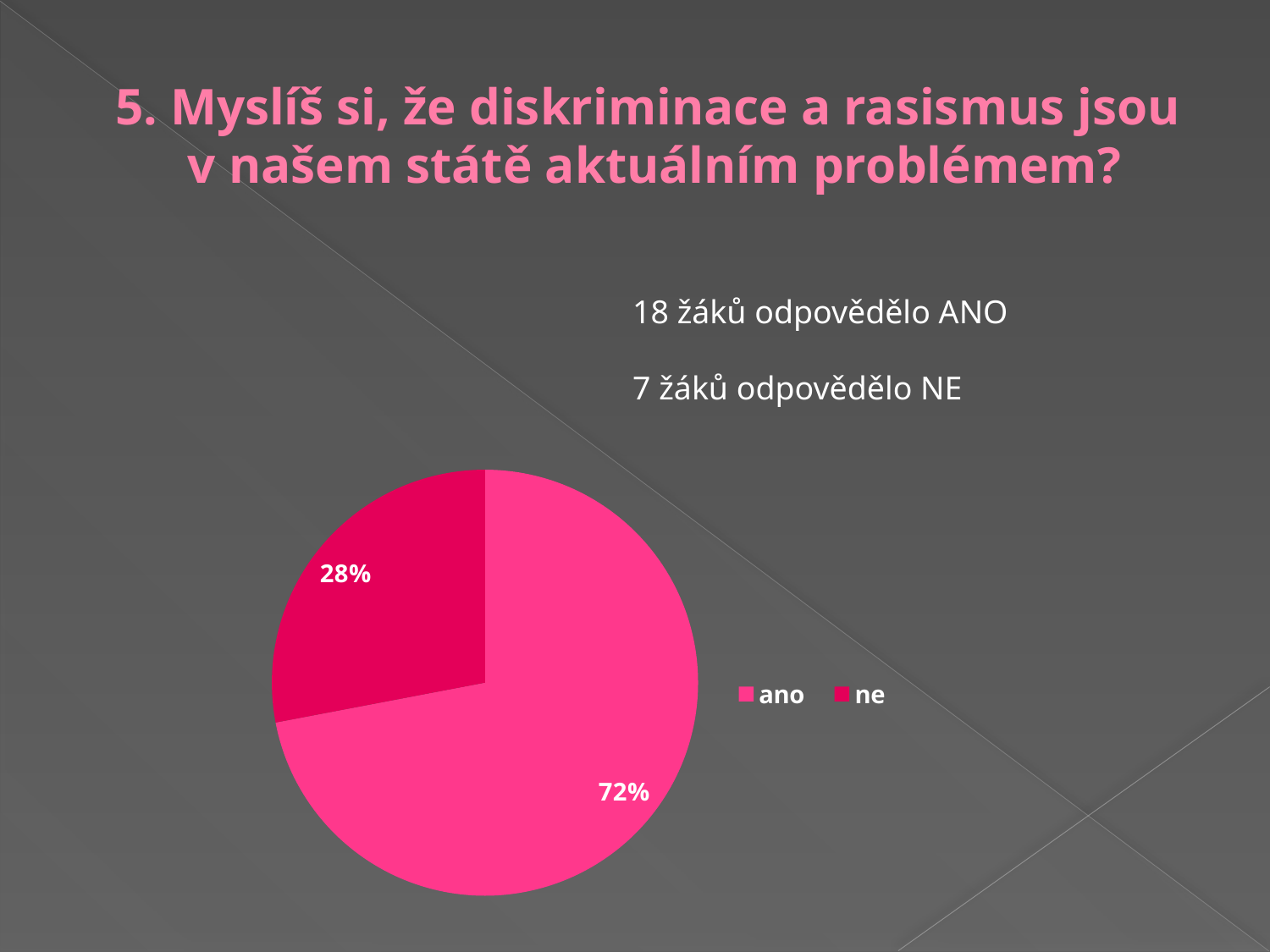
What kind of chart is shown on the slide? pie chart What are the two legend entries of the pie chart? ano, ne How many slices does the pie chart have? 2 Which is larger, the "ano" slice or the "ne" slice? ano What share of the pie does the "ano" slice represent? 72% What is the difference in percentage points between the "ano" and "ne" slices? 44 How many entries does the legend list? 2 Is the share of the "ne" slice greater or less than 50%? less Which slice of the pie is the smallest? ne Where is the legend positioned relative to the pie? to the right What share of the pie does the "ne" slice represent? 28% Which slice of the pie is the largest? ano